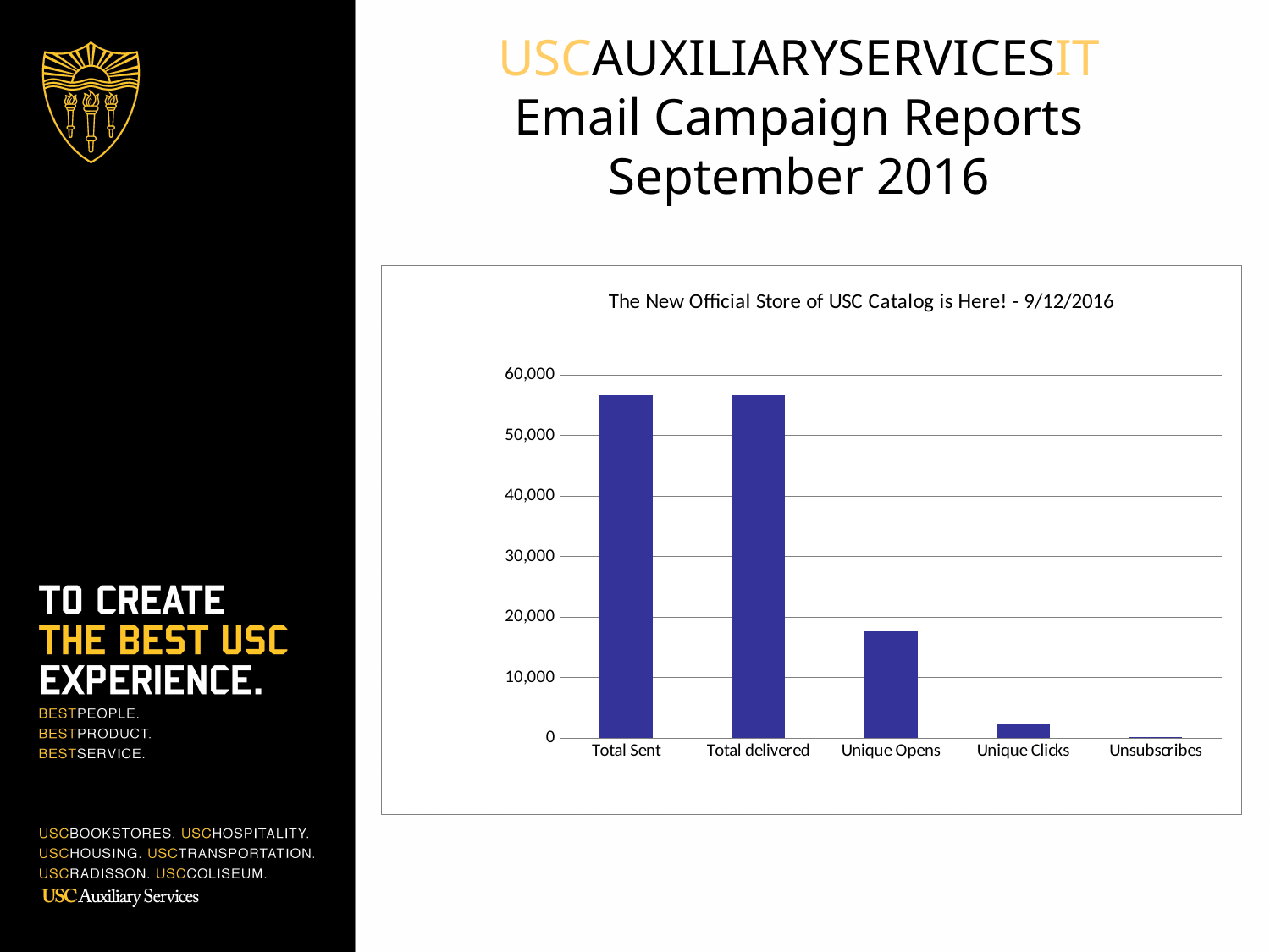
Is the value for Unique Opens greater or less than 20,000? less Is the value for Unique Opens greater or less than 10,000? greater Which is larger, the value for Unique Opens or the value for Unique Clicks? Unique Opens Do the values generally rise or fall moving from left to right along the x axis? fall Is the value for Unique Clicks greater or less than 10,000? less What colour are the bars in the chart? blue How many categories are plotted on the x axis of the chart? 5 Which category has the lowest value in the chart? Unsubscribes What is the title of the chart? The New Official Store of USC Catalog is Here! - 9/12/2016 What kind of chart is shown on the slide? bar chart